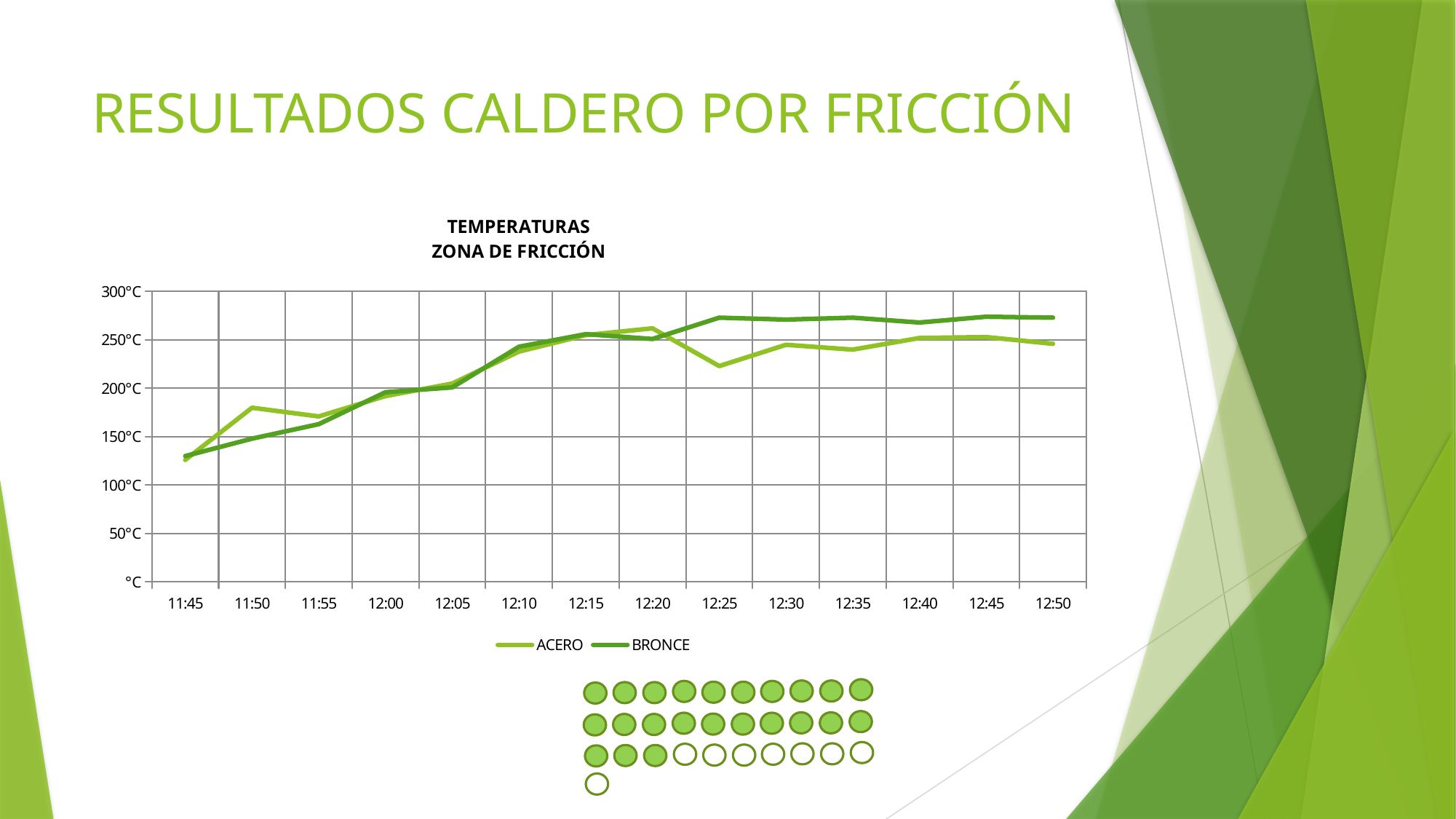
Does the BRONCE series generally rise or fall from 11:45 to 12:25? rise Is the value for ACERO at 11:50 greater or less than 150°C? greater How many series does the legend list? 2 What are the names of the two series in the legend? ACERO and BRONCE How many time points are shown on the x axis? 14 Is the value for ACERO at 12:25 greater or less than 250°C? less Is the value for BRONCE at 12:25 greater or less than 250°C? greater What is the title of the chart? TEMPERATURAS ZONA DE FRICCIÓN What kind of chart is shown on the slide? line chart At 12:25, which series has the higher value, ACERO or BRONCE? BRONCE At 11:50, which series has the higher value, ACERO or BRONCE? ACERO